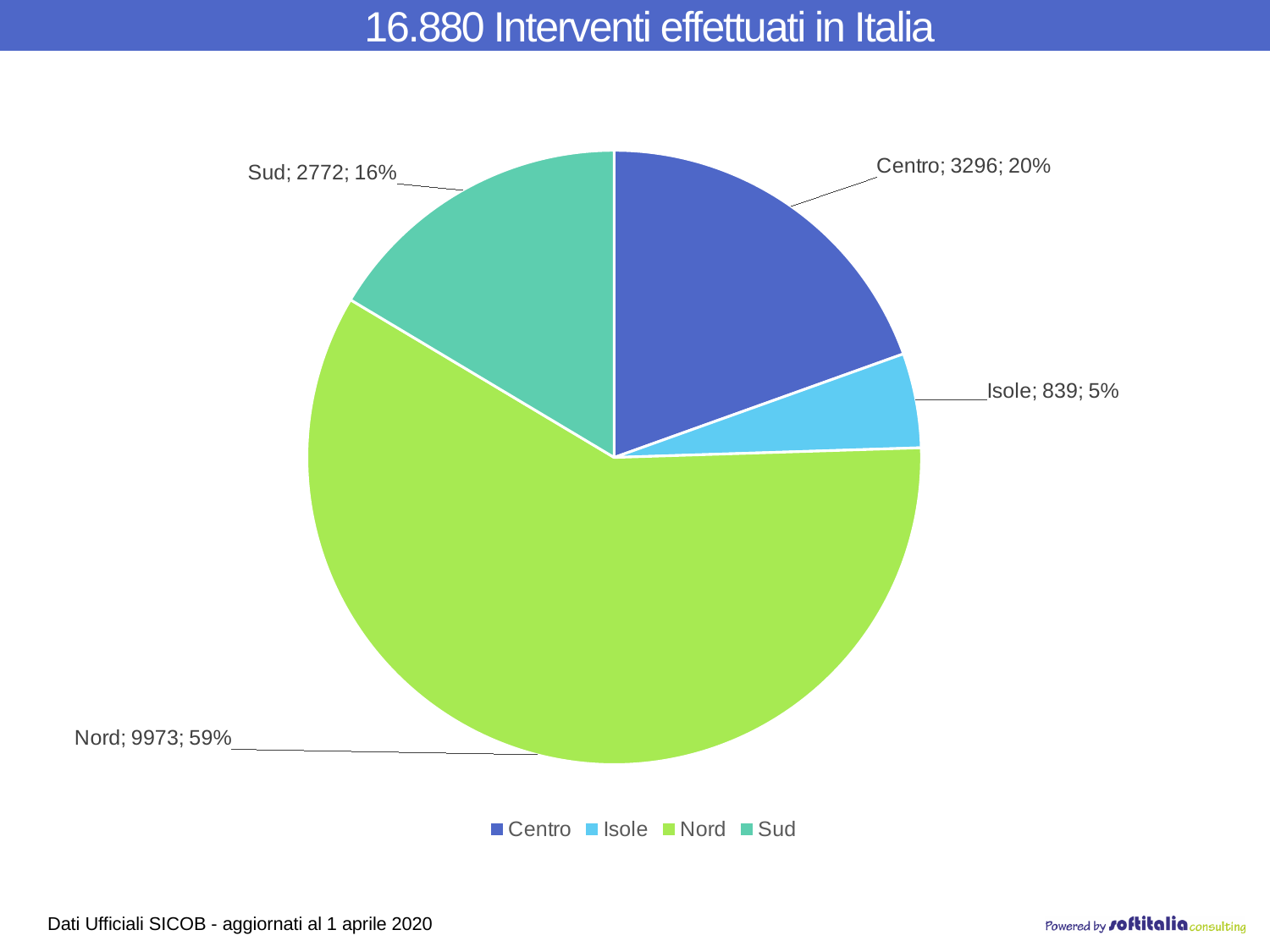
How many slices does the pie chart have? 4 Which is larger, the value for Sud or the value for Isole? Sud What percentage share does the Centro slice have? 20% What is the title of the chart? 16.880 Interventi effettuati in Italia Which region has the smallest slice of the pie? Isole Which region has the largest slice of the pie? Nord What kind of chart is shown on the slide? pie chart What is the difference between the values for Centro and Sud? 524 How many interventions does the Nord slice represent? 9973 What is the value shown for Isole? 839 Which legend entry is shown in dark blue? Centro What percentage share does the Sud slice have? 16%